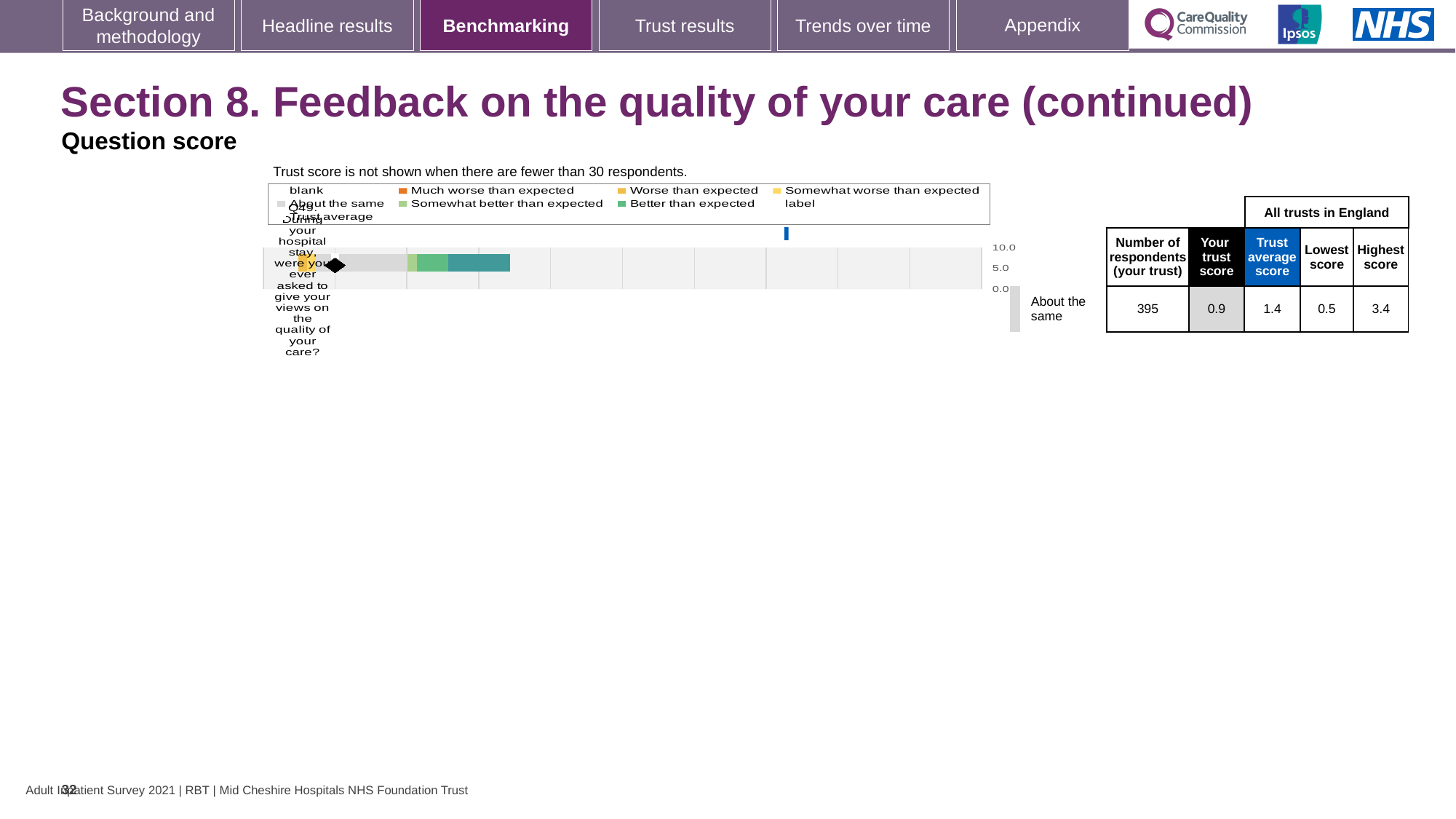
Which benchmark category is the trust placed in for Q49? About the same What is the trust's score for Q49 (During your hospital stay, were you ever asked to give your views on the quality of your care?)? 0.9 Which is larger for Q49: the trust's score or the trust average score? Trust average score How many respondents from the trust answered Q49? 395 How many questions are plotted in the benchmarking chart on this slide? 1 What is the lowest score among all trusts in England for Q49? 0.5 By how much does the trust average score exceed the trust's own score for Q49? 0.5 What kind of chart is used to show the Q49 benchmarking result? bar chart What is the highest score among all trusts in England for Q49? 3.4 What is the difference between the highest and lowest scores for Q49 across all trusts in England? 2.9 What is the trust average score for Q49? 1.4 Is the trust's score for Q49 greater or less than 5.0? less